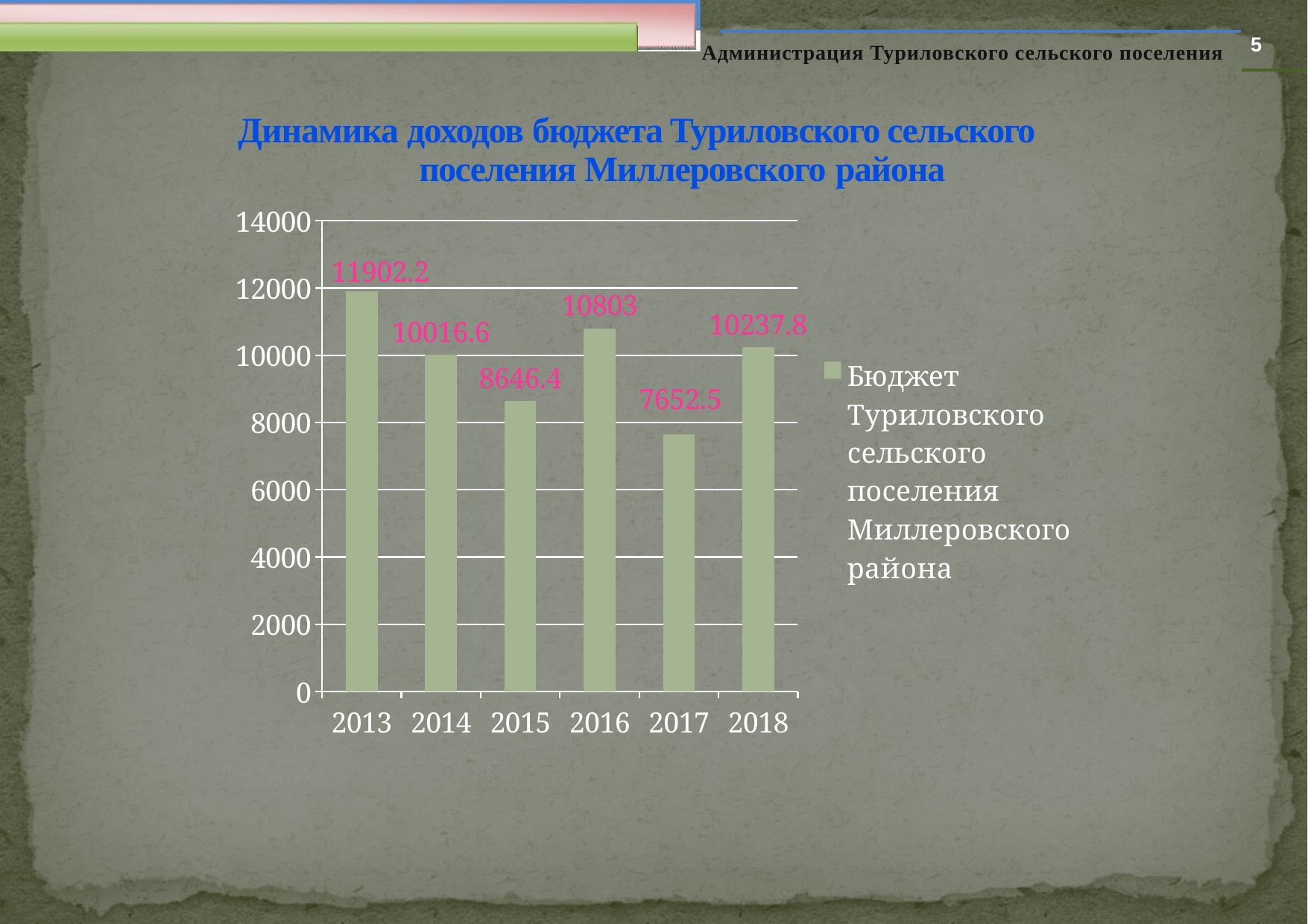
Which year has the lowest budget value? 2017 Does the budget value rise or fall from 2017 to 2018? rise What is the budget value for 2017? 7652.5 Is the value for 2015 greater or less than 8000? greater What kind of chart is shown on the slide? bar chart Which year has the highest budget value? 2013 What is the budget value for 2013? 11902.2 Which is larger, the budget value for 2016 or for 2018? 2016 What is the difference between the budget values for 2013 and 2014? 1885.6 How many series does the legend list? 1 What is the budget value for 2016? 10803 How many years are shown on the x axis? 6